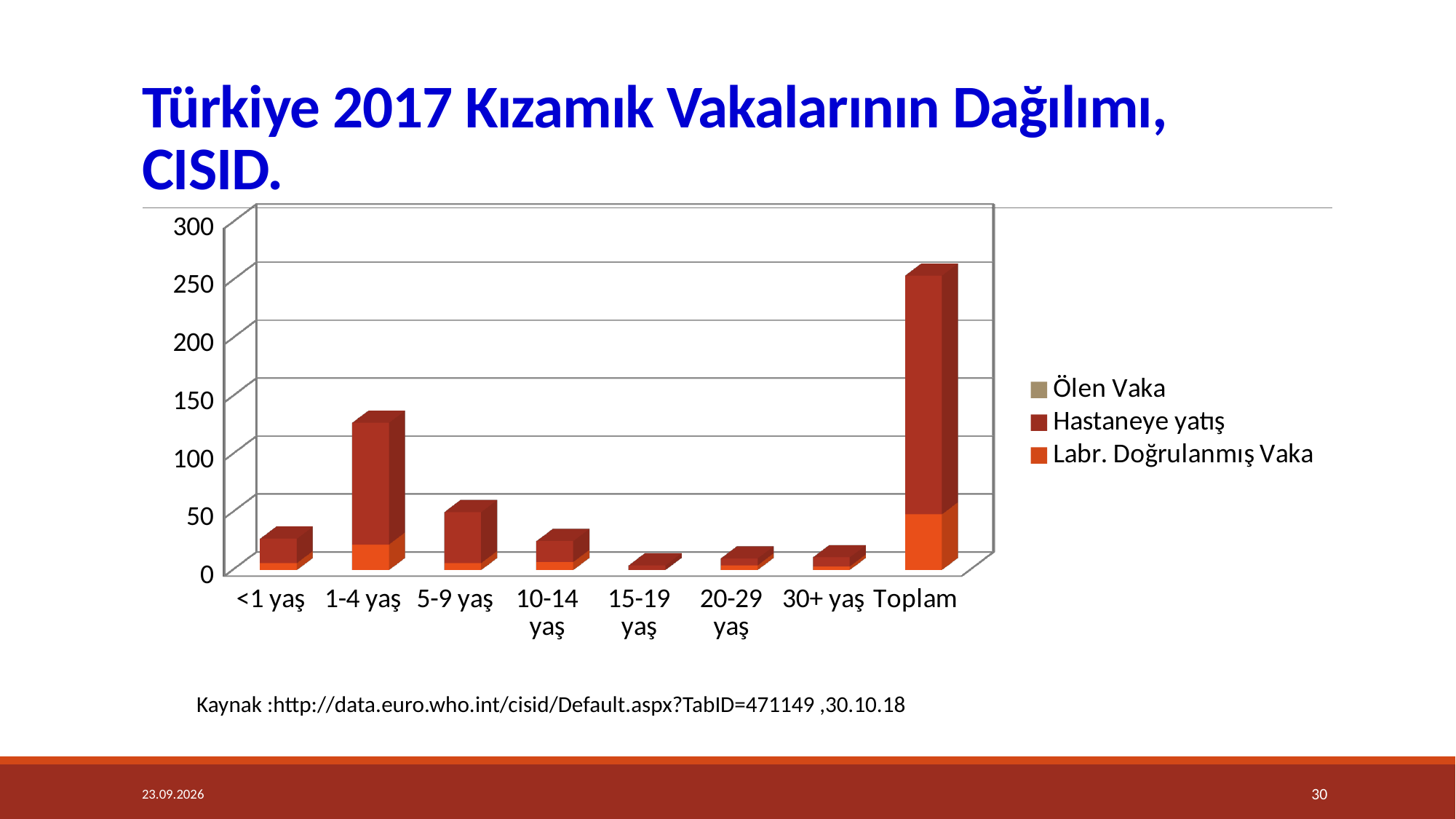
How many series does the chart legend list? 3 Which category has the tallest bar in the chart? Toplam Among the age groups (excluding Toplam), which category has the tallest bar? 1-4 yaş How many categories are shown on the x axis of the chart? 8 Is the total bar height for <1 yaş greater or less than 50? less Is the total bar height for Toplam greater or less than 200? greater What kind of chart is shown on the slide? bar chart Is the total bar height for 1-4 yaş greater or less than 150? less Which bar is taller, <1 yaş or 15-19 yaş? <1 yaş Which series in the legend is shown in orange? Labr. Doğrulanmış Vaka Which bar is taller, 1-4 yaş or 5-9 yaş? 1-4 yaş